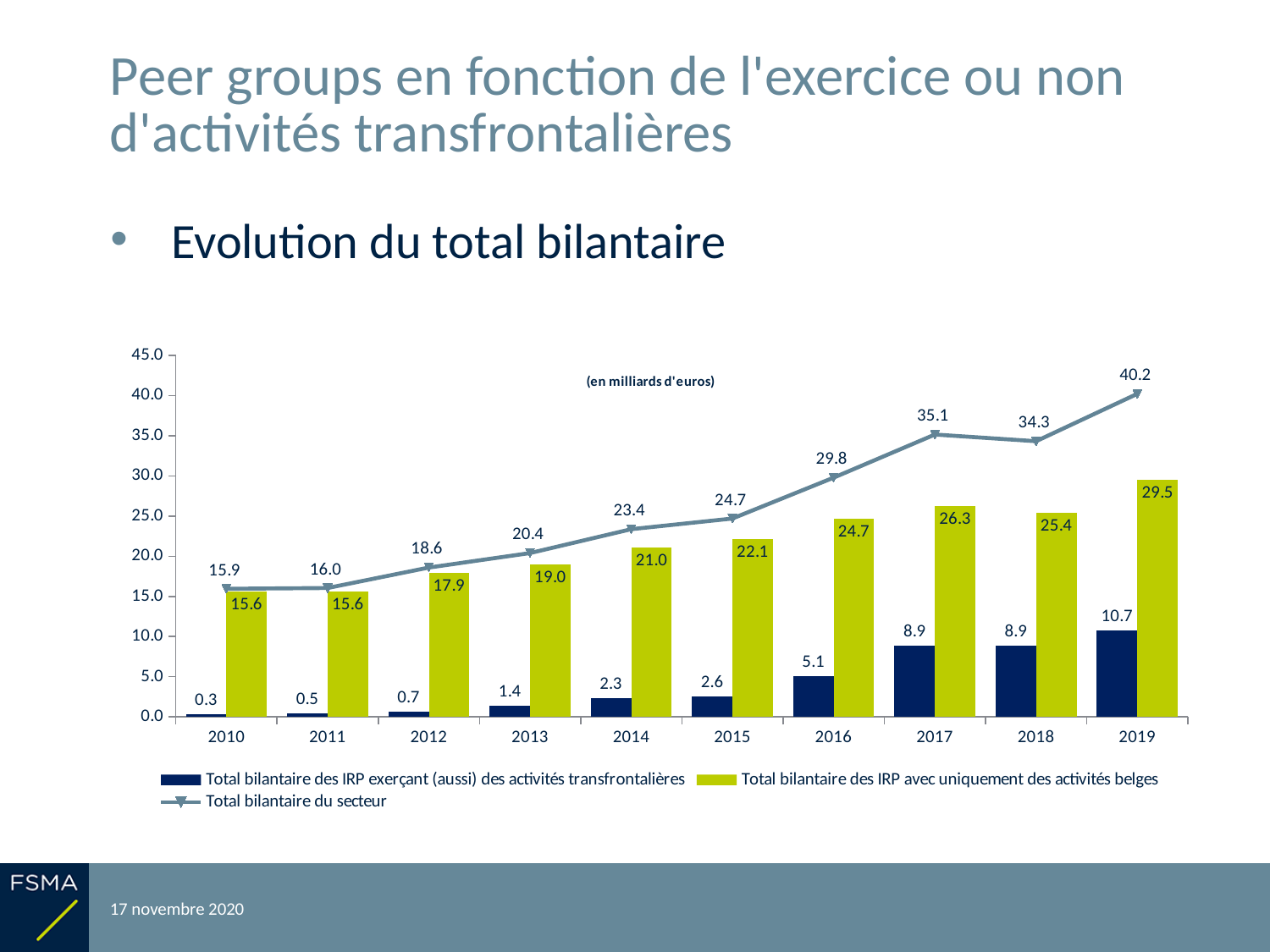
What is the difference between 'Total bilantaire du secteur' in 2019 and in 2018? 5.9 How many series does the legend list? 3 Does 'Total bilantaire des IRP avec uniquement des activités belges' rise or fall from 2010 to 2017? rise What is the value of 'Total bilantaire des IRP avec uniquement des activités belges' in 2019? 29.5 Which is larger: 'Total bilantaire des IRP avec uniquement des activités belges' in 2017 or in 2018? 2017 In which year is 'Total bilantaire du secteur' highest? 2019 In which year is 'Total bilantaire des IRP exerçant (aussi) des activités transfrontalières' lowest? 2010 Is the value of 'Total bilantaire du secteur' in 2016 greater or less than 25.0? greater What is the value of 'Total bilantaire du secteur' in 2017? 35.1 What unit is stated on the chart for the values? en milliards d'euros What is the value of 'Total bilantaire des IRP exerçant (aussi) des activités transfrontalières' in 2016? 5.1 How many years are shown on the x axis? 10